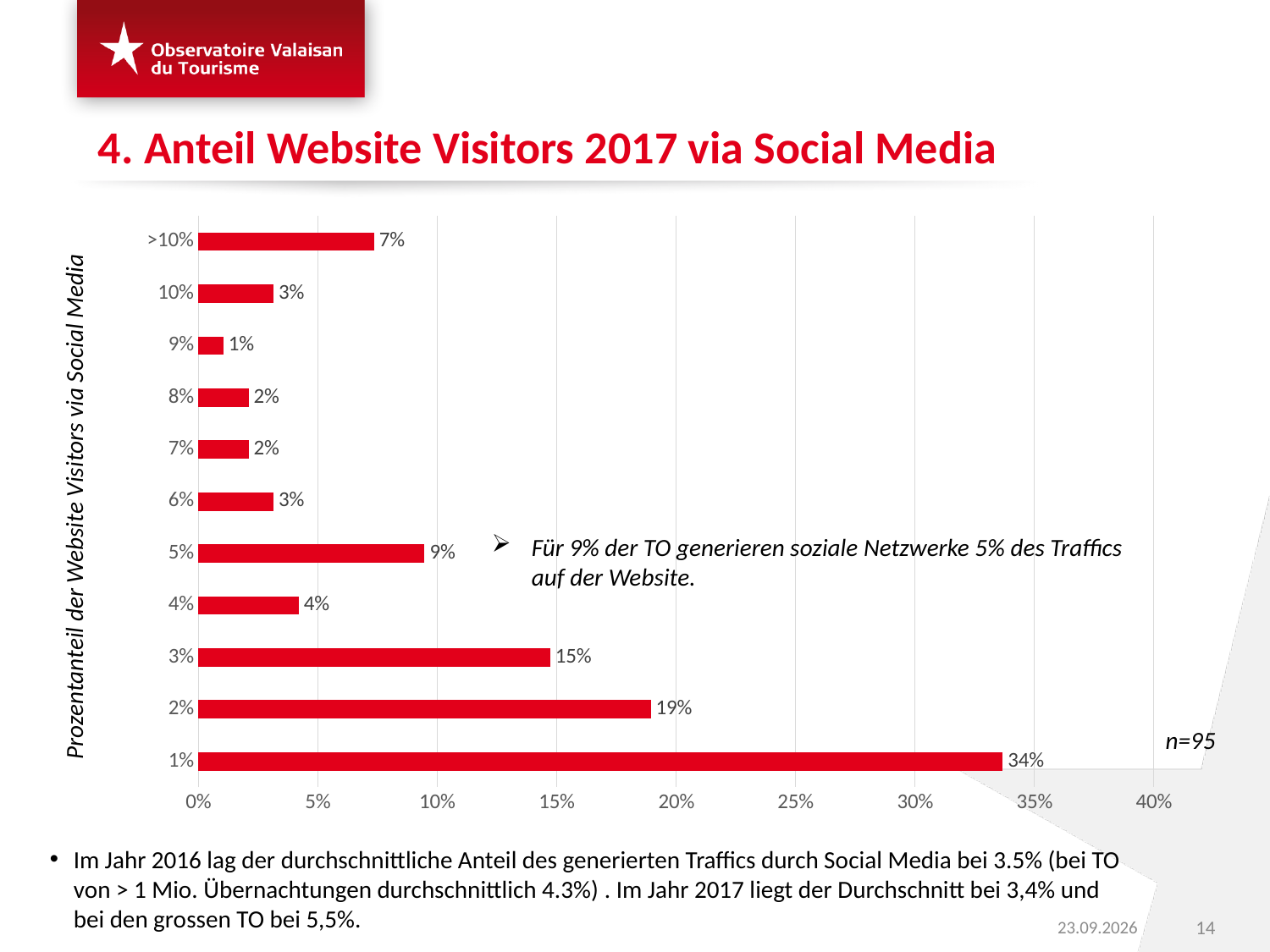
Which has a larger value, the '4%' category or the '5%' category? 5% Which category has the highest value? 1% How many categories are shown on the y axis of the chart? 11 What percentage of tourism organisations is shown for the '1%' category? 34% What is the difference between the values for the '1%' and '2%' categories? 15% What kind of chart is shown on the slide? Bar chart What value is shown for the '3%' category? 15% Which category has the lowest value? 9% What value is shown for the '>10%' category? 7% What value is shown for the '5%' category? 9% Is the value for the '2%' category greater or less than 15%? greater What is the sample size (n) noted on the chart? n=95